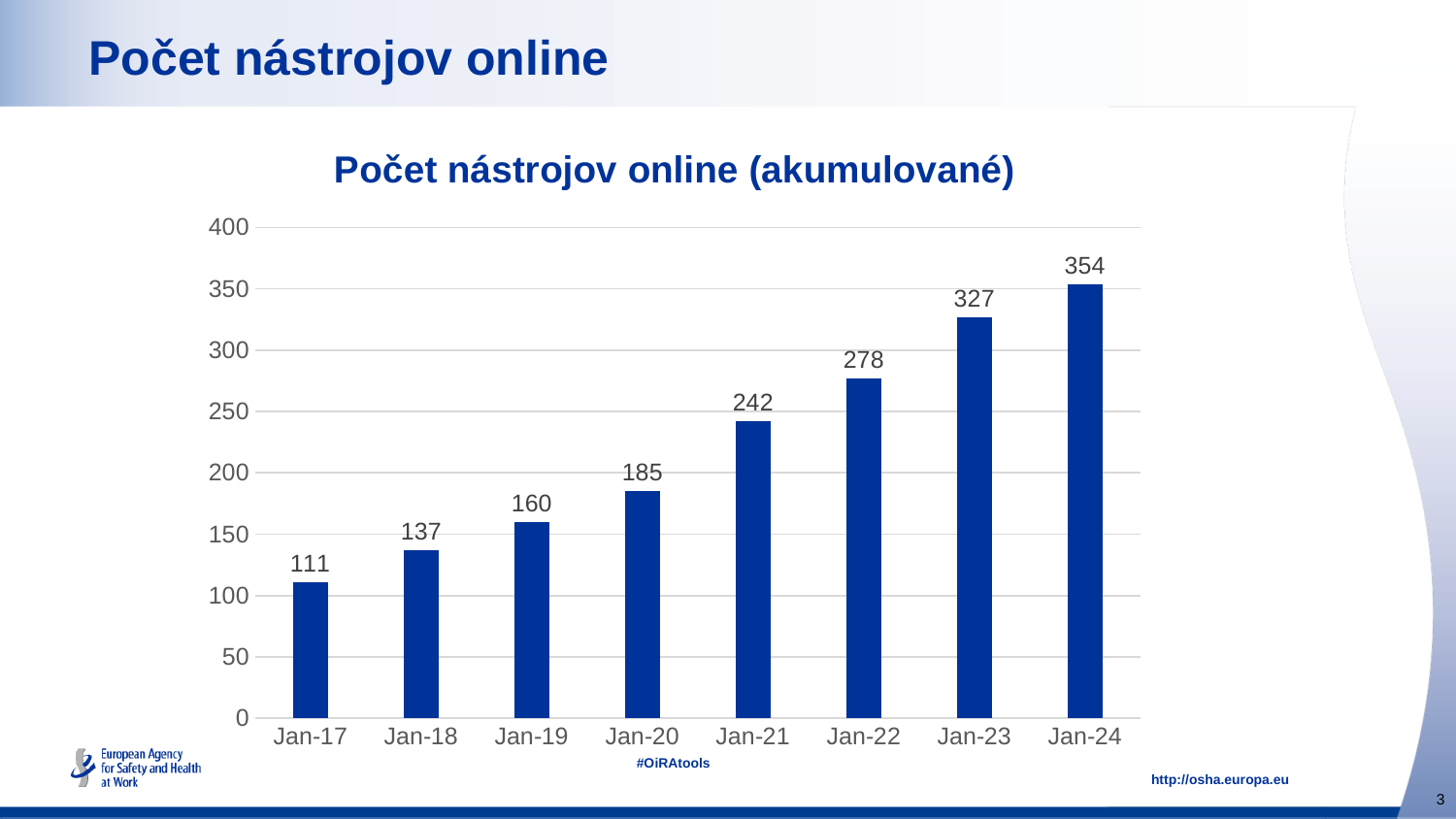
What kind of chart is shown on the slide? bar chart How many categories are shown on the x axis? 8 What is the difference between the values for Jan-24 and Jan-23? 27 Is the value for Jan-23 greater or less than 300? greater What is the value for Jan-17? 111 What is the value for Jan-21? 242 Which category has the highest value? Jan-24 What is the difference between the values for Jan-20 and Jan-17? 74 Which is larger, the value for Jan-19 or the value for Jan-22? Jan-22 Which category has the lowest value? Jan-17 What is the value for Jan-24? 354 Do the values rise or fall from Jan-17 to Jan-24? rise